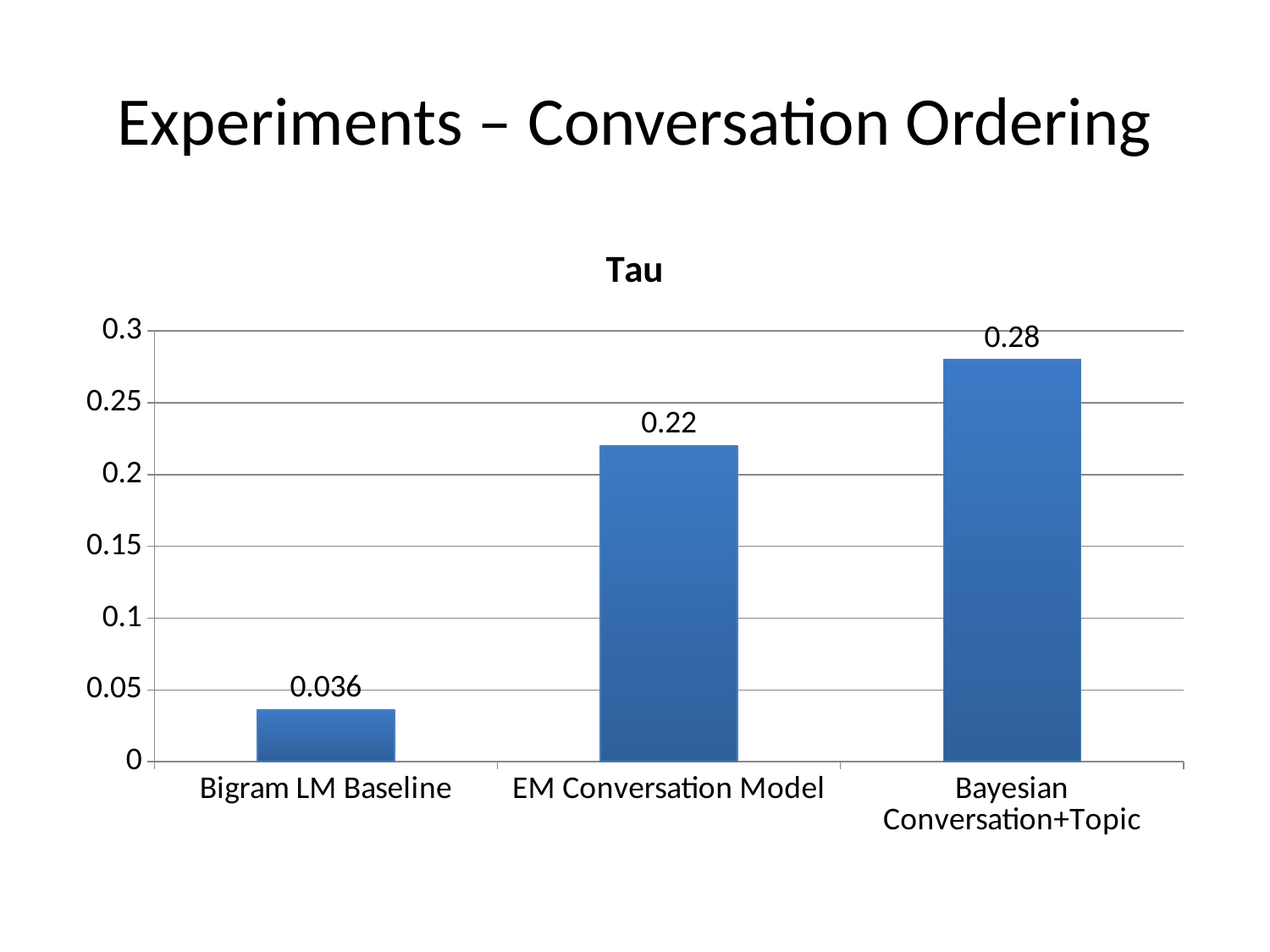
What is the difference in Tau between Bayesian Conversation+Topic and EM Conversation Model? 0.06 Which has a larger Tau value, EM Conversation Model or Bigram LM Baseline? EM Conversation Model What kind of chart is shown on the slide? bar chart How many categories are shown in the chart? 3 What is the difference in Tau between EM Conversation Model and Bigram LM Baseline? 0.184 Is the Tau value for EM Conversation Model greater or less than 0.25? less Which category has the highest Tau value? Bayesian Conversation+Topic Which category has the lowest Tau value? Bigram LM Baseline What is the title of the chart? Tau What is the Tau value for Bayesian Conversation+Topic? 0.28 What is the Tau value for Bigram LM Baseline? 0.036 What is the Tau value for EM Conversation Model? 0.22